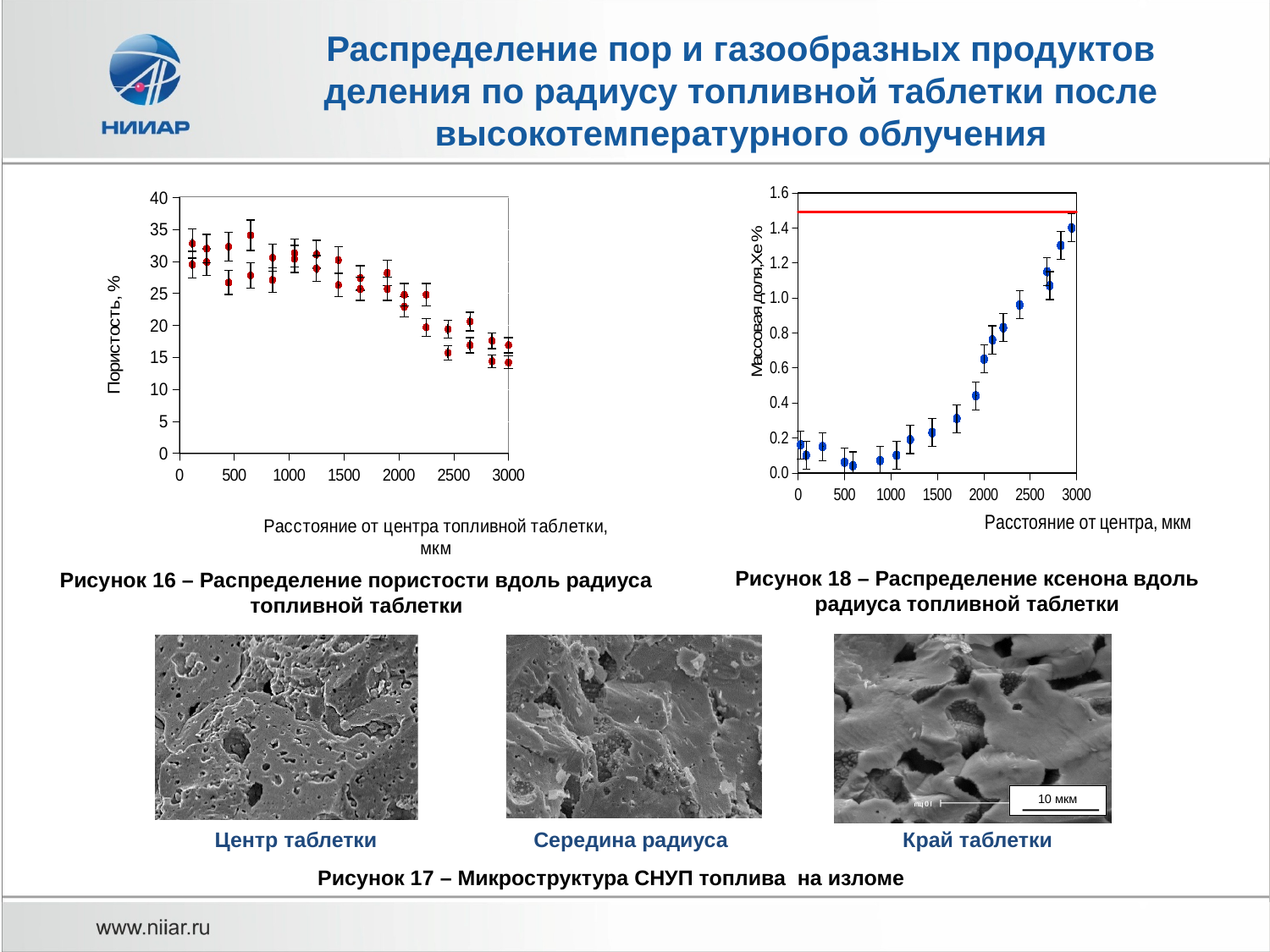
In the chart titled 'Рисунок 16', are the porosity values near 3000 мкм greater or less than 20? less In the chart titled 'Рисунок 18', do the xenon values rise or fall as the distance from the centre increases along the x axis? rise In the chart titled 'Рисунок 16', is the porosity value at the far left of the x axis larger or smaller than the value at the far right? larger In the chart titled 'Рисунок 18', what is the label of the y axis? Массовая доля,Xe % In the chart titled 'Рисунок 18 – Распределение ксенона вдоль радиуса топливной таблетки', what kind of chart is it? scatter chart In the chart titled 'Рисунок 16 – Распределение пористости вдоль радиуса топливной таблетки', what kind of chart is it? scatter chart In the chart titled 'Рисунок 18', are the xenon values near 3000 мкм greater or less than 1.2? greater In the chart titled 'Рисунок 18', is the xenon value at the far right of the x axis larger or smaller than the value at the far left? larger In the chart titled 'Рисунок 16', what is the maximum value shown on the y axis? 40 In the chart titled 'Рисунок 18', are the xenon values near 500 мкм greater or less than 0.4? less In the chart titled 'Рисунок 16', do the porosity values rise or fall as the distance from the centre increases along the x axis? fall